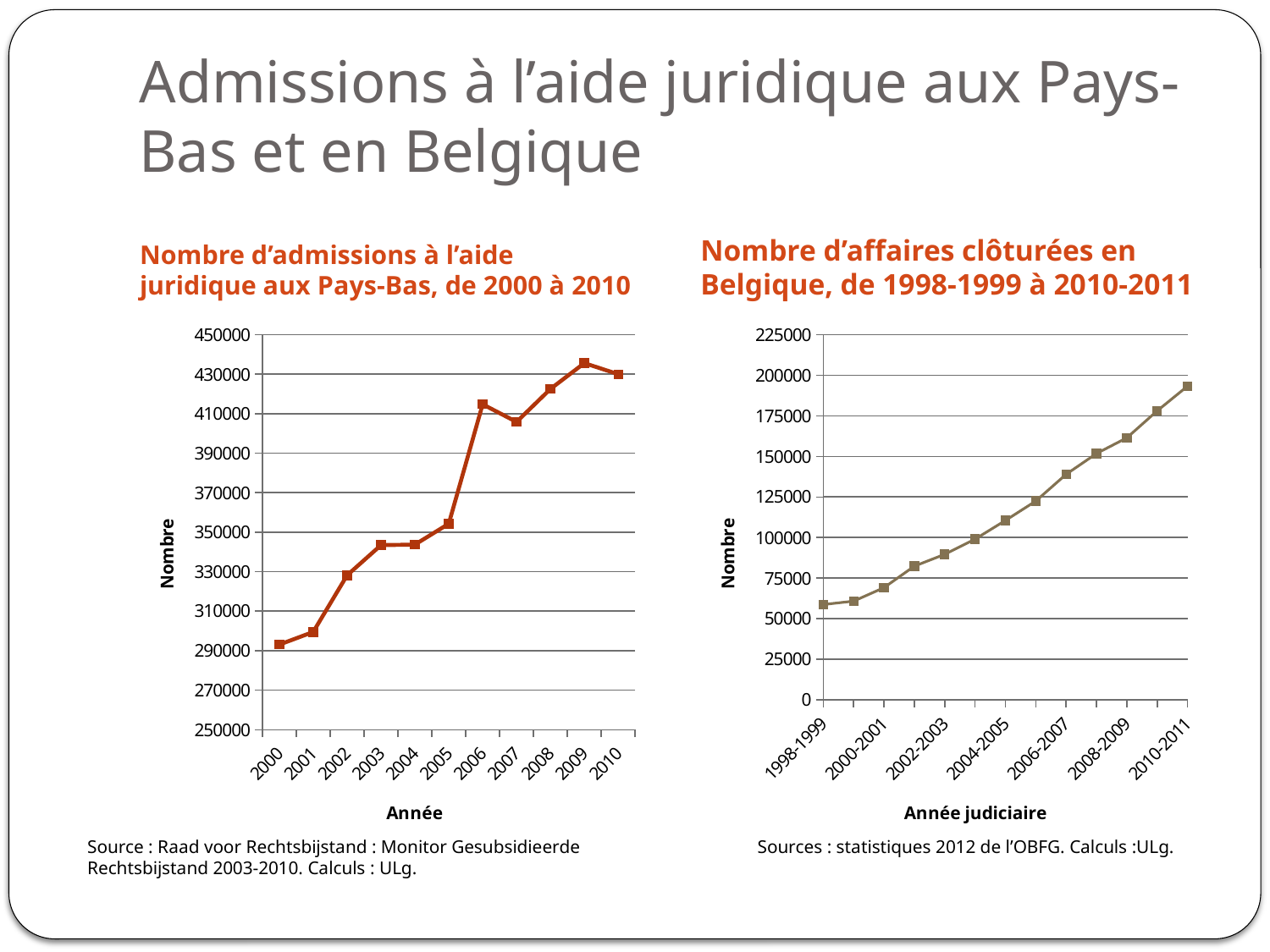
In the left chart (Pays-Bas), which year has the highest number of admissions? 2009 What is the x-axis title of the right chart (Belgique)? Année judiciaire In the left chart (Pays-Bas), is the value for 2000 greater or less than 310000? less How many years are plotted in the left chart (Pays-Bas)? 11 In the left chart (Pays-Bas), which year has the lowest number of admissions? 2000 In the right chart (Belgique), do the values generally rise or fall from 1998-1999 to 2010-2011? rise In the right chart (Belgique), is the value for 2010-2011 greater or less than 200000? less In the right chart (Belgique), is the value for 1998-1999 greater or less than 50000? greater In the left chart (Pays-Bas), which year has the larger value, 2006 or 2007? 2006 What kind of chart is the left chart, 'Nombre d'admissions à l'aide juridique aux Pays-Bas, de 2000 à 2010'? Line chart In the right chart (Belgique), which judicial year has the highest number of closed cases? 2010-2011